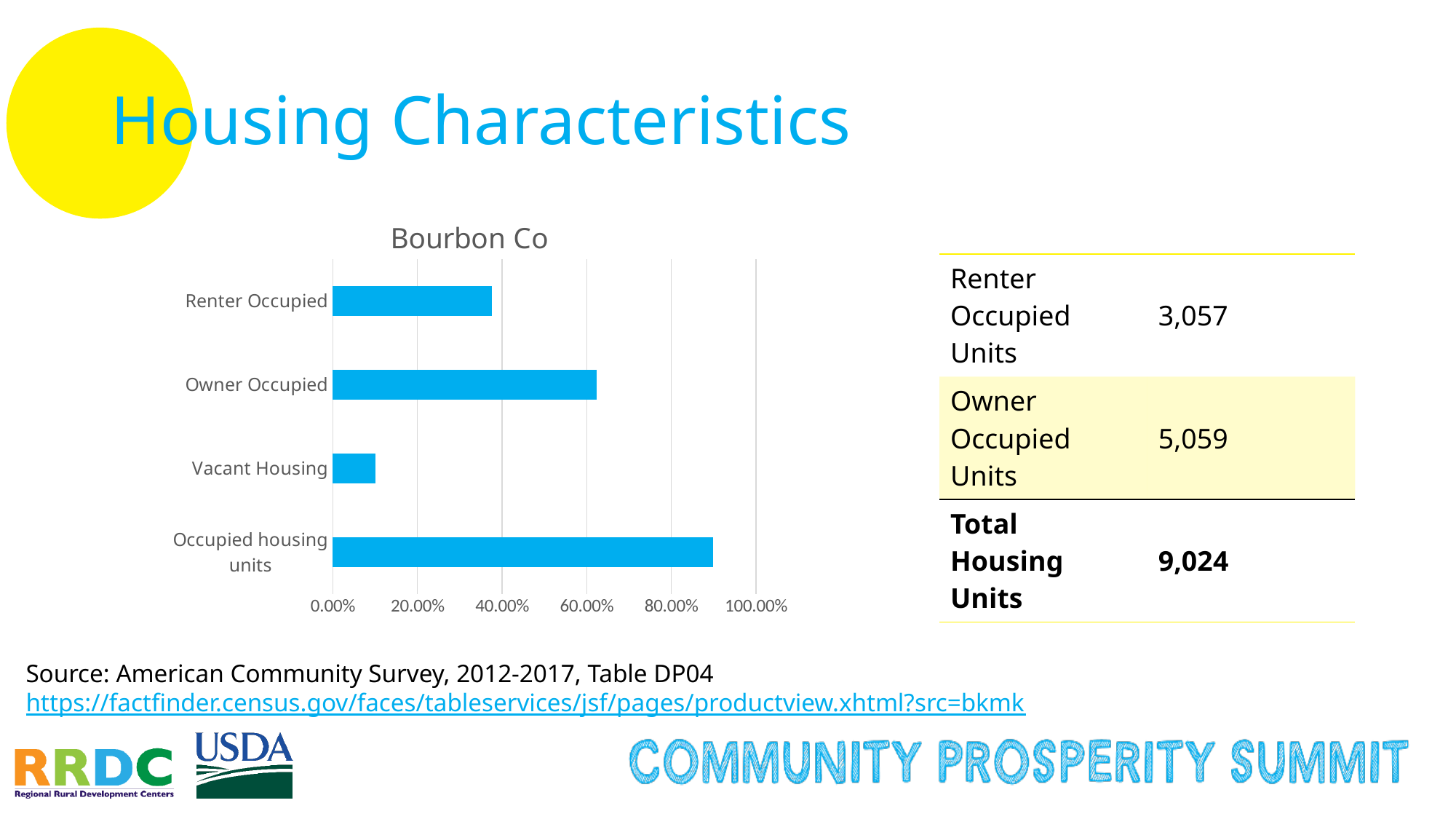
Is the value for Occupied housing units greater or less than 80.00%? greater Is the value for Renter Occupied greater or less than 20.00%? greater Which is larger, the value for Owner Occupied or the value for Renter Occupied? Owner Occupied What is the title of the chart? Bourbon Co Which category has the highest value in the chart? Occupied housing units Is the value for Vacant Housing greater or less than 20.00%? less Which category has the lowest value in the chart? Vacant Housing What colour are the bars in the chart? blue What kind of chart is shown on the slide? bar chart How many categories are plotted in the chart? 4